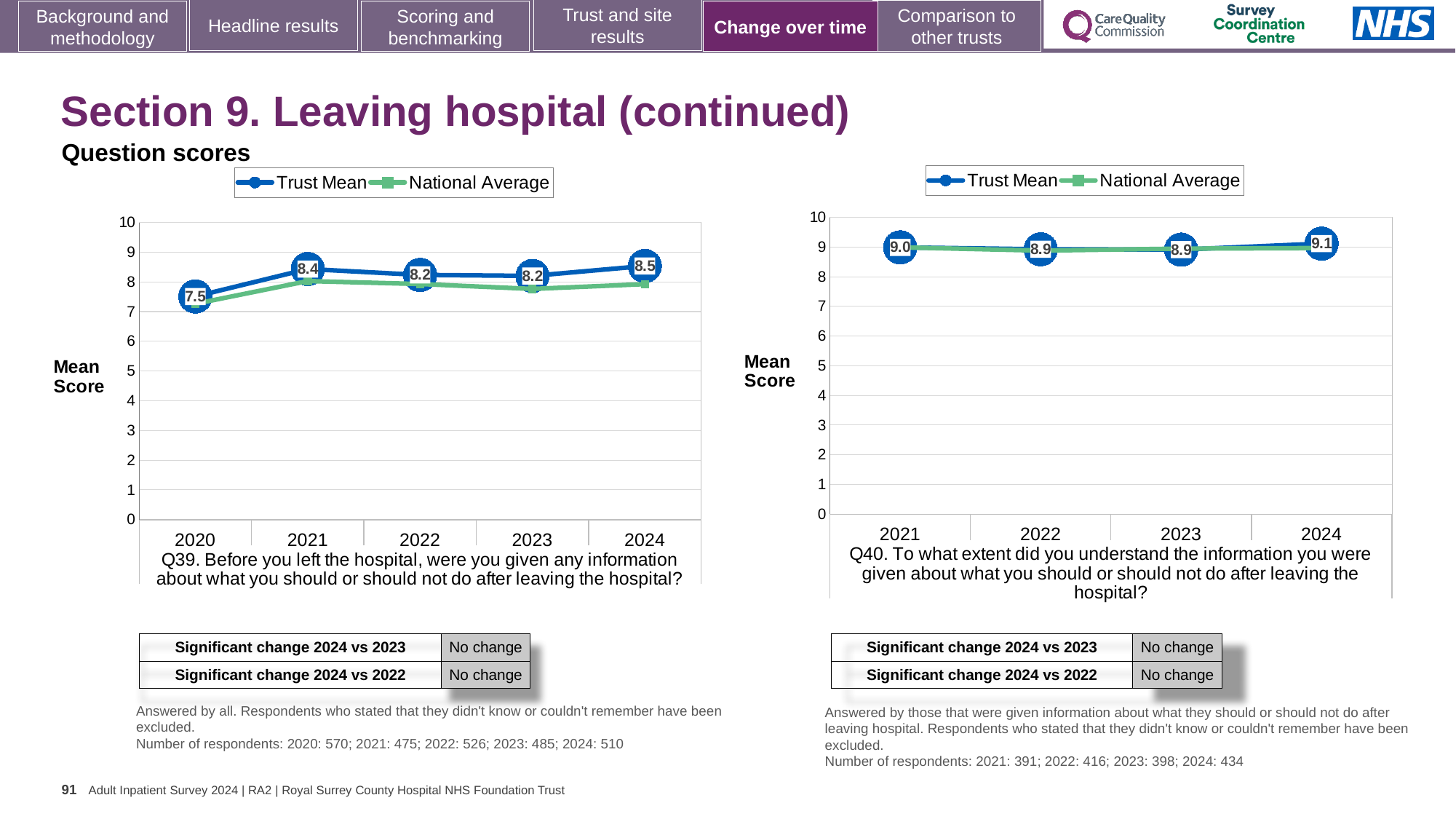
In the Q40 chart (right), what is the Trust Mean score for 2024? 9.1 What kind of chart is the Q39 chart (left)? Line chart In the Q39 chart (left), which year has the highest Trust Mean score? 2024 In the Q39 chart (left), what is the Trust Mean score for 2024? 8.5 In the Q39 chart (left), what is the Trust Mean score for 2020? 7.5 In the Q39 chart (left), which year has the lowest Trust Mean score? 2020 In the Q40 chart (right), how many years are plotted on the x axis? 4 How many series does the legend of the Q40 chart (right) list? 2 In the Q39 chart (left), is the National Average for 2020 greater or less than 8? less In the Q39 chart (left), how many years are plotted on the x axis? 5 In the Q40 chart (right), what is the Trust Mean score for 2022? 8.9 In the Q39 chart (left), what is the difference between the Trust Mean scores for 2021 and 2020? 0.9